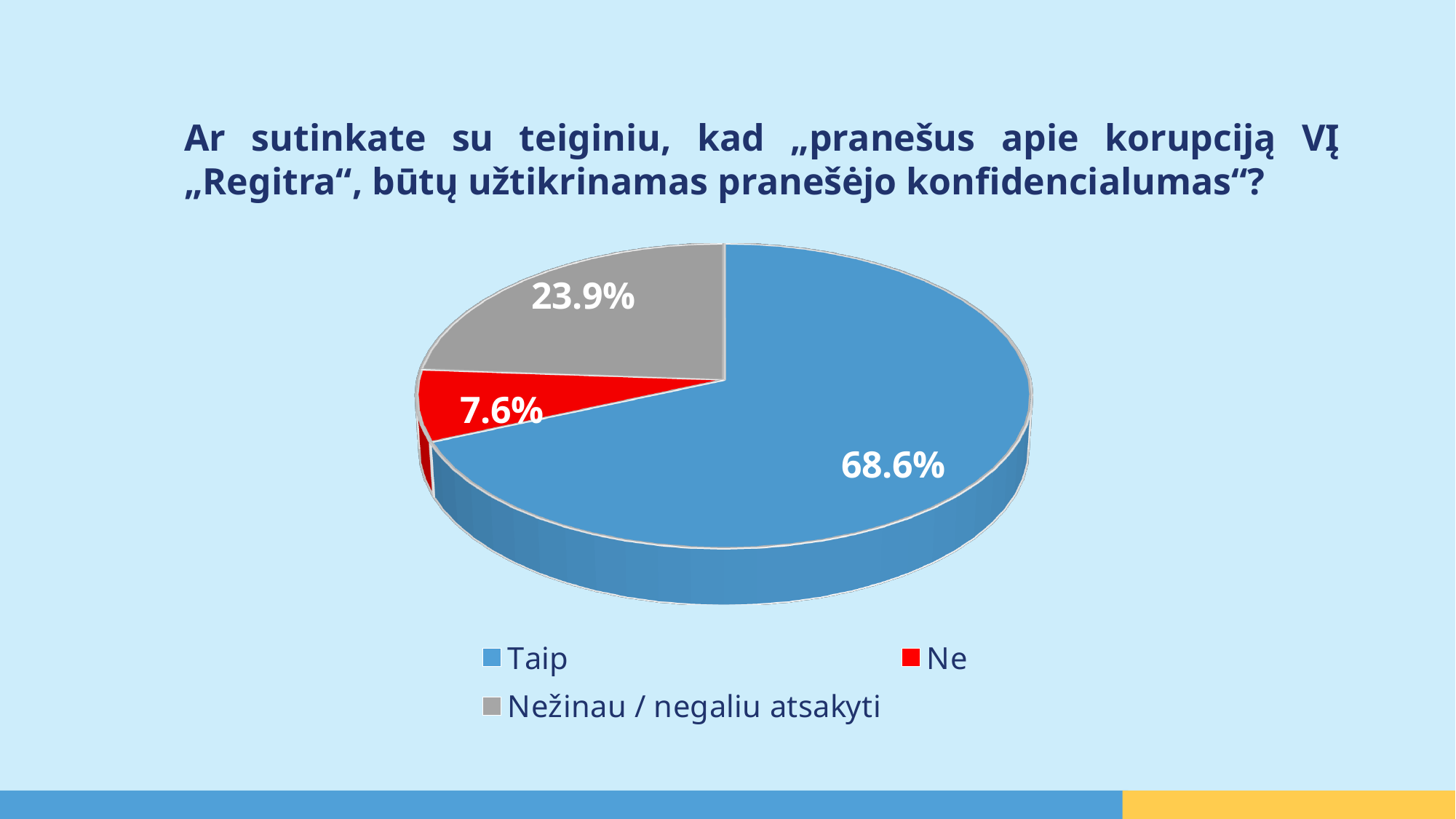
What is the difference in percentage points between "Nežinau / negaliu atsakyti" and "Ne"? 16.3 Which answer has the largest share of the pie? Taip What percentage of respondents answered "Nežinau / negaliu atsakyti"? 23.9% Which is larger, the share for "Ne" or the share for "Nežinau / negaliu atsakyti"? Nežinau / negaliu atsakyti Which answer has the smallest share of the pie? Ne How many slices does the pie chart have? 3 What percentage of respondents answered "Ne"? 7.6% What colour is the slice for "Ne"? red What percentage of respondents answered "Taip"? 68.6% How many entries does the legend list? 3 What kind of chart is shown on the slide? pie chart What is the difference in percentage points between "Taip" and "Nežinau / negaliu atsakyti"? 44.7